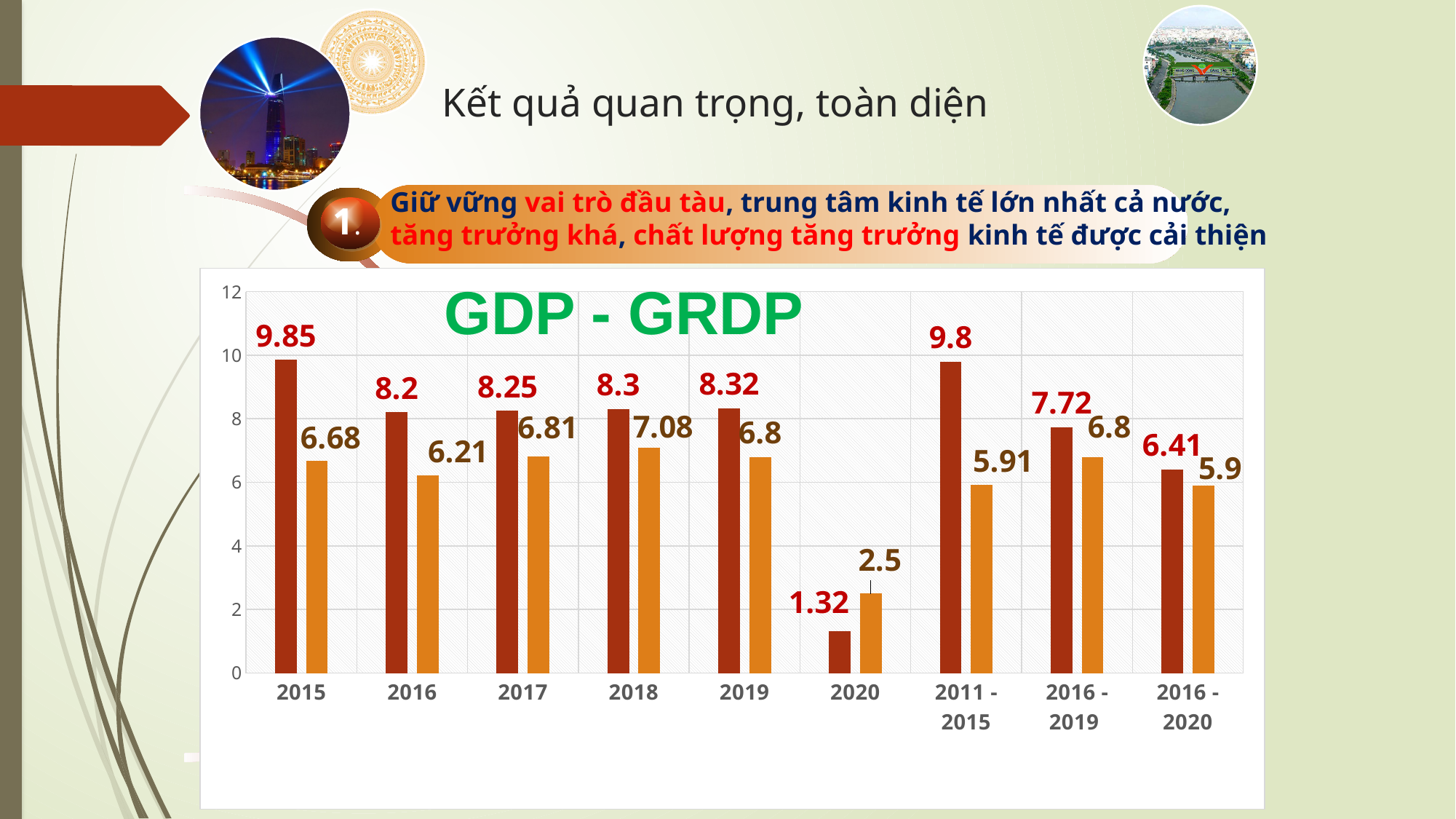
Which category has the lowest dark red bar? 2020 How many categories are shown on the x axis of the chart? 9 Which category has the highest orange bar? 2018 Do the dark red bars rise or fall from 2019 to 2020? fall What is the value of the orange bar for 2011 - 2015? 5.91 What is the title of the chart? GDP - GRDP Is the value of the dark red bar for 2016 - 2020 greater or less than 8? less What type of chart is shown on the slide? bar chart For 2020, which bar is larger, the dark red bar or the orange bar? the orange bar What is the difference between the dark red bar and the orange bar for 2017? 1.44 What is the value of the dark red bar for 2015? 9.85 What is the value of the orange bar for 2018? 7.08